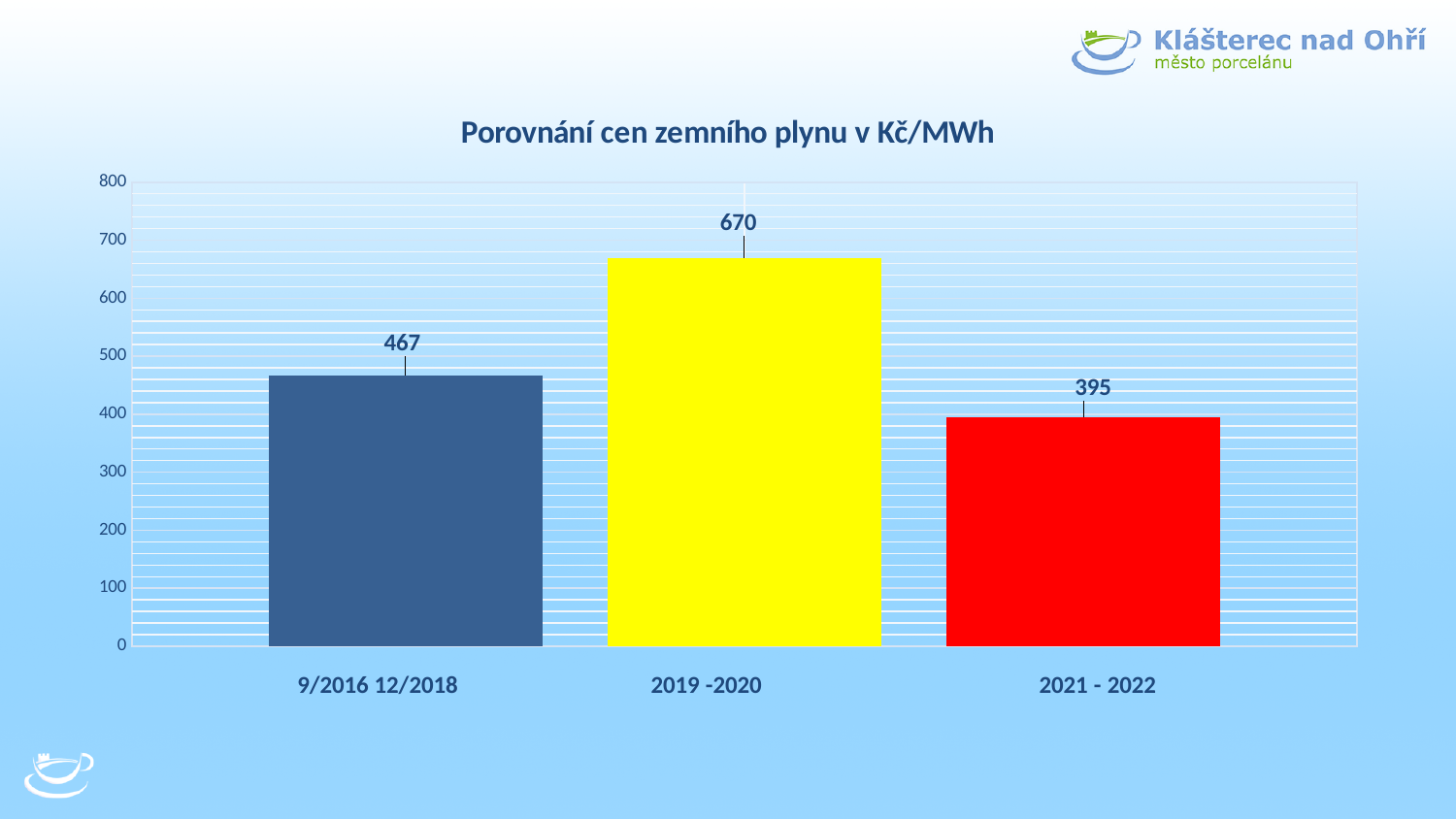
What is the value for 2019 -2020? 670 How many periods are shown on the chart? 3 What is the value for 9/2016 12/2018? 467 What is the difference between the values for 2019 -2020 and 9/2016 12/2018? 203 What is the difference between the values for 2019 -2020 and 2021 - 2022? 275 What is the title of the chart? Porovnání cen zemního plynu v Kč/MWh What is the value for 2021 - 2022? 395 Which is larger, the value for 9/2016 12/2018 or the value for 2021 - 2022? 9/2016 12/2018 Which period has the lowest value? 2021 - 2022 What kind of chart is shown on the slide? bar chart Which period has the highest value? 2019 -2020 Is the value for 2021 - 2022 greater or less than 400? less